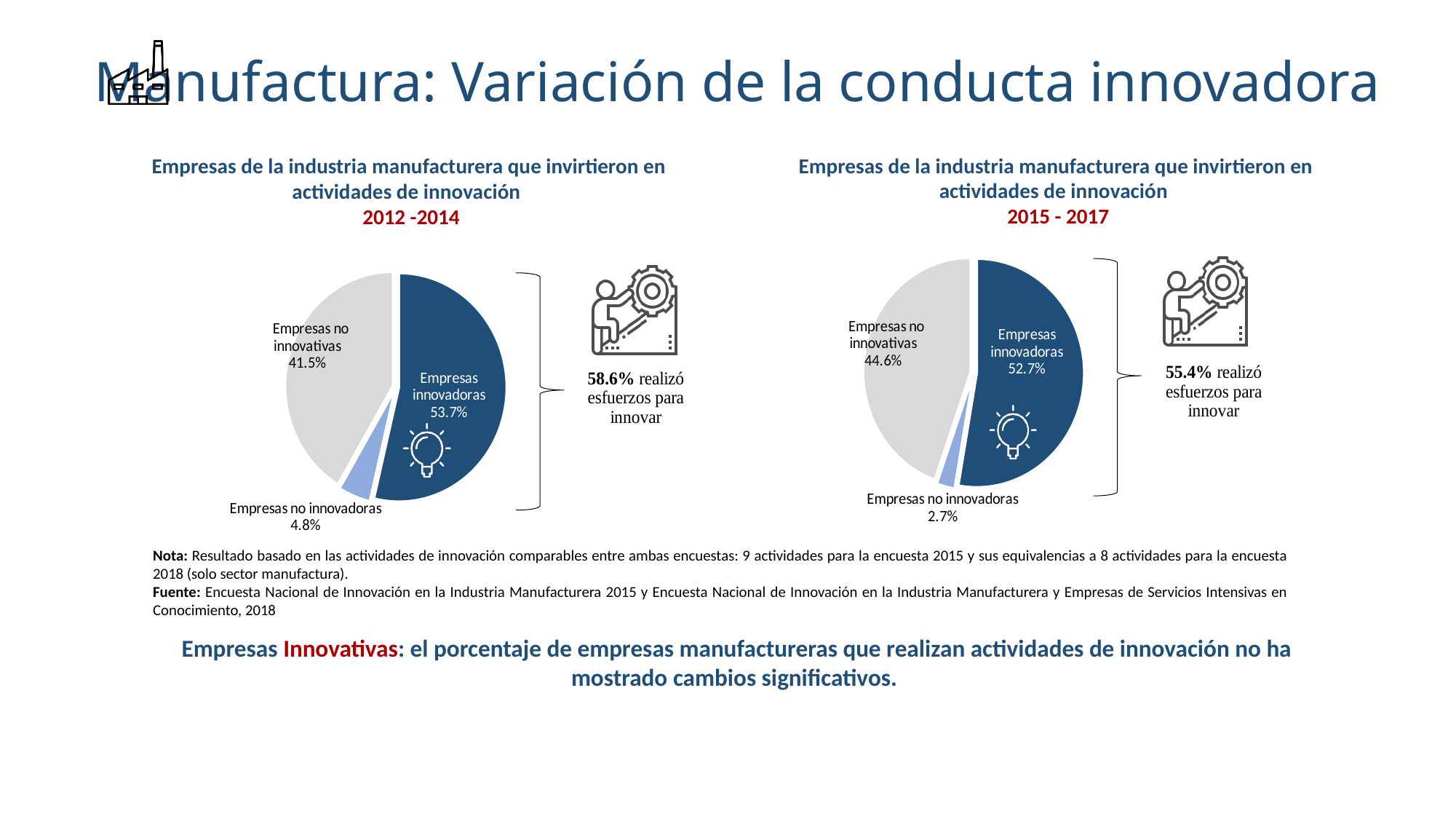
In the 2012-2014 pie chart, what share is labelled for Empresas no innovativas? 41.5% In the 2015-2017 pie chart, what share is labelled for Empresas no innovativas? 44.6% In the 2012-2014 pie chart, what share is labelled for Empresas innovadoras? 53.7% In the 2015-2017 pie chart, what share is labelled for Empresas no innovadoras? 2.7% Which is larger: the Empresas no innovativas share in the 2012-2014 chart or in the 2015-2017 chart? 2015-2017 What is the difference between the Empresas innovadoras share in the 2012-2014 chart and in the 2015-2017 chart? 1.0% What type of chart is used on this slide? Pie chart How many slices does the 2015-2017 pie chart have? 3 In the 2012-2014 pie chart, which slice is the largest? Empresas innovadoras In the 2012-2014 pie chart, what share is labelled for Empresas no innovadoras? 4.8% In the 2015-2017 pie chart, what share is labelled for Empresas innovadoras? 52.7% In the 2015-2017 pie chart, which slice is the smallest? Empresas no innovadoras